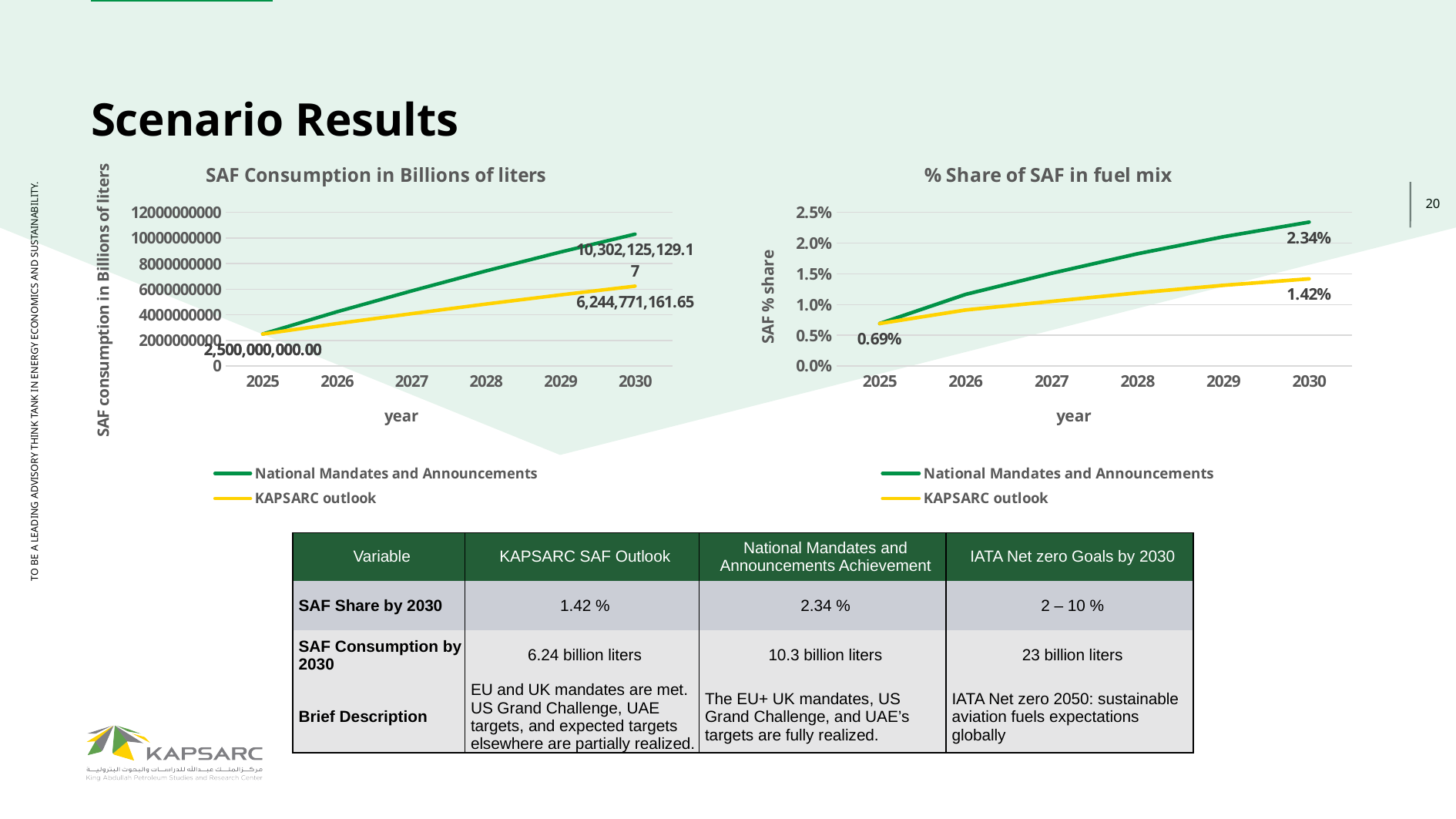
In the '% Share of SAF in fuel mix' chart, what is the 2030 value for the National Mandates and Announcements series? 2.34% In the 'SAF Consumption in Billions of liters' chart, do the values rise or fall from 2025 to 2030? Rise In the 'SAF Consumption in Billions of liters' chart, what value is labelled at 2025? 2,500,000,000.00 In the 'SAF Consumption in Billions of liters' chart, what is the 2030 value for the National Mandates and Announcements series? 10,302,125,129.17 How many series does the legend of the 'SAF Consumption in Billions of liters' chart list? 2 In the '% Share of SAF in fuel mix' chart, is the KAPSARC outlook value for 2028 greater or less than 1.5%? less In the 'SAF Consumption in Billions of liters' chart, which series has the higher value in 2030? National Mandates and Announcements What kind of chart is the '% Share of SAF in fuel mix' chart? Line chart How many years are shown on the x axis of the '% Share of SAF in fuel mix' chart? 6 In the '% Share of SAF in fuel mix' chart, what is the 2030 value for the KAPSARC outlook series? 1.42% In the 'SAF Consumption in Billions of liters' chart, what is the 2030 value for the KAPSARC outlook series? 6,244,771,161.65 In the '% Share of SAF in fuel mix' chart, what is the difference between the two series' 2030 values? 0.92%